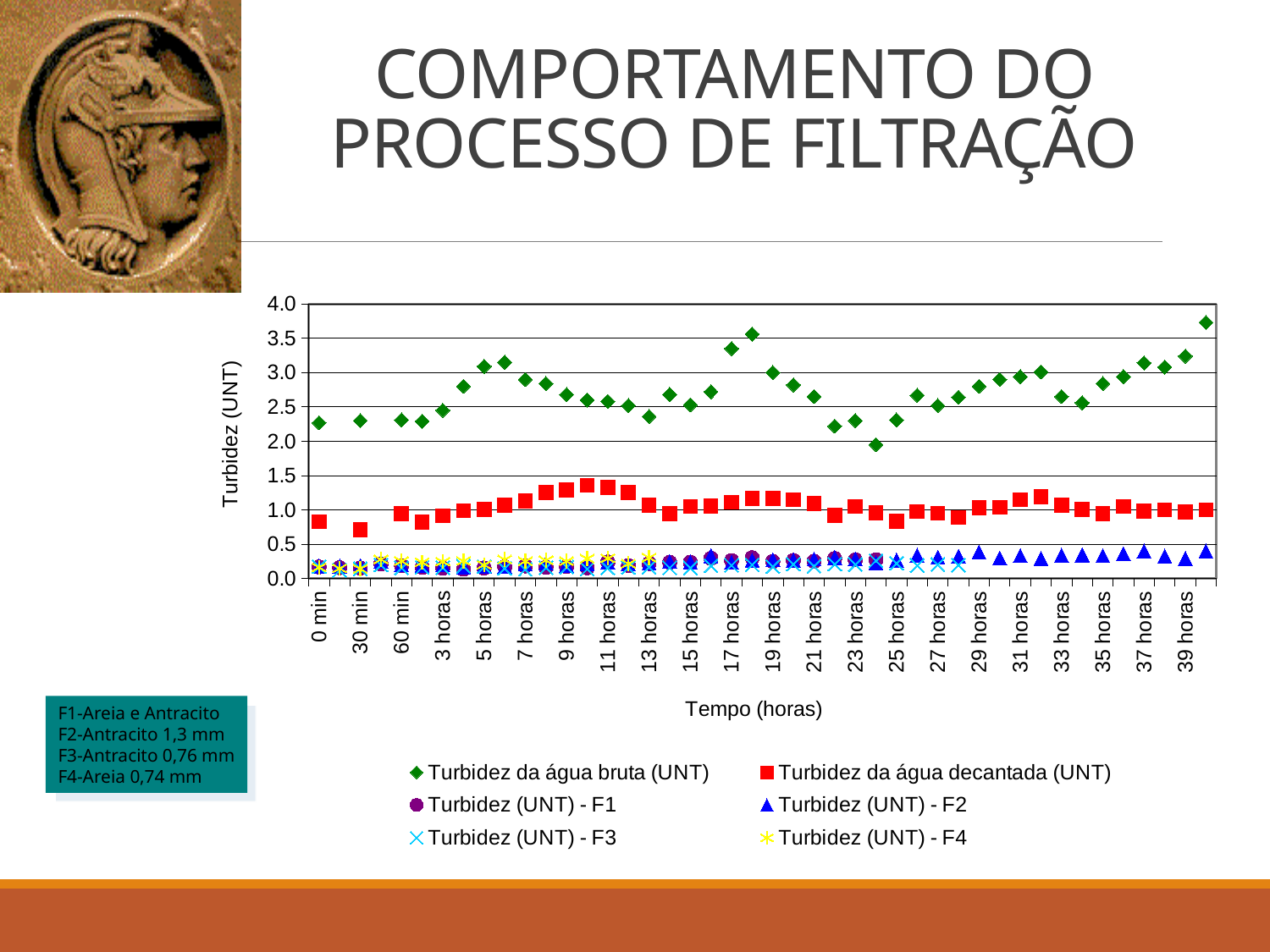
Which series has the highest values throughout the chart? Turbidez da água bruta (UNT) Is the value for Turbidez da água bruta (UNT) at 0 min greater or less than 2.0? greater At 17 horas, which is larger: Turbidez da água bruta (UNT) or Turbidez da água decantada (UNT)? Turbidez da água bruta (UNT) At 39 horas, which is larger: Turbidez da água decantada (UNT) or Turbidez (UNT) - F2? Turbidez da água decantada (UNT) What is the title of the horizontal axis of the chart? Tempo (horas) Does Turbidez da água bruta (UNT) rise or fall from 29 horas to 39 horas? rise How many series does the chart legend list? 6 What kind of chart is shown on the slide? scatter chart Is the value for Turbidez da água decantada (UNT) at 0 min greater or less than 0.5? greater Is the value for Turbidez da água bruta (UNT) at 39 horas greater or less than 3.5? less What is the title of the vertical axis of the chart? Turbidez (UNT)